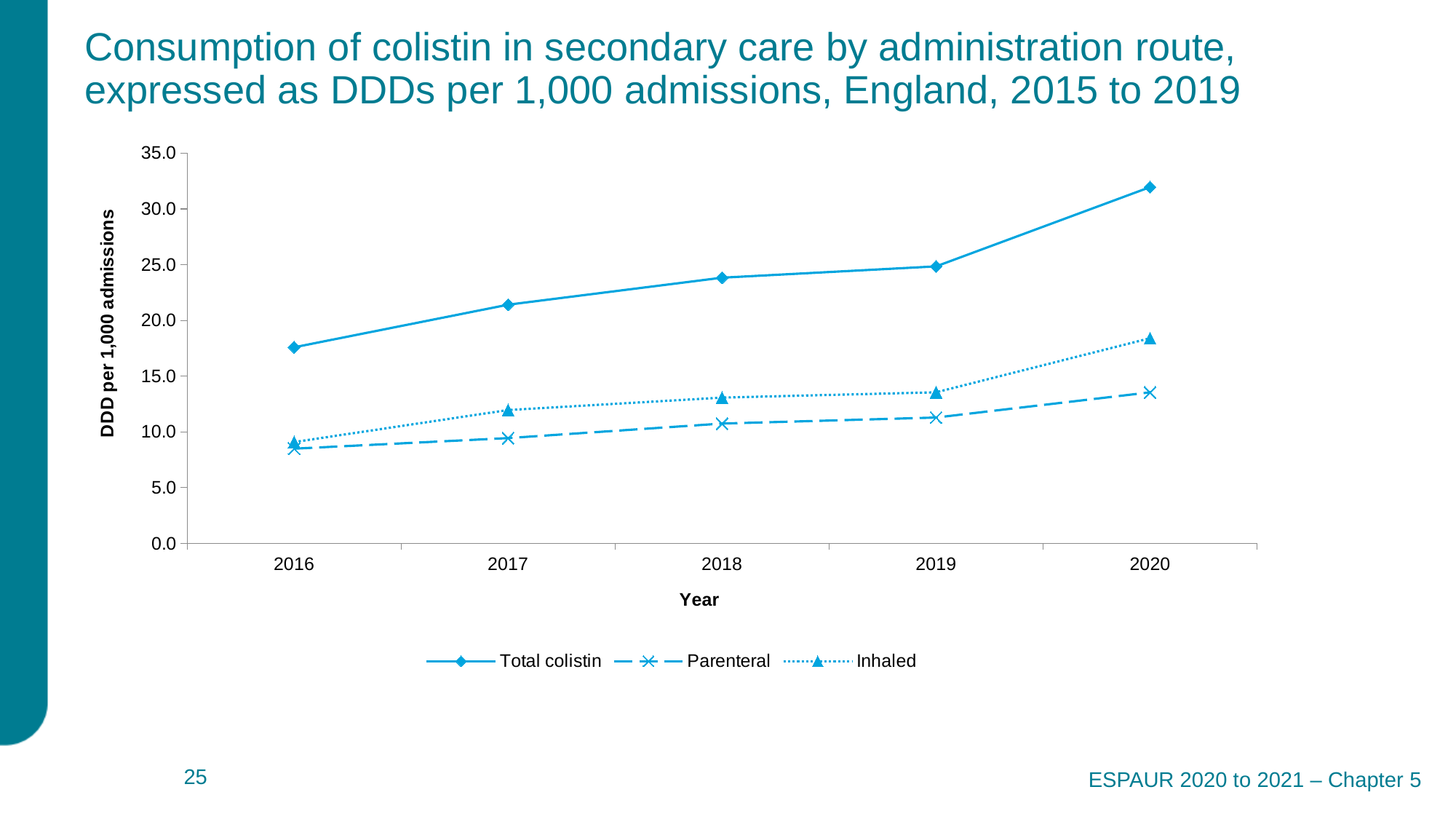
Does the Total colistin series rise or fall from 2016 to 2020? rise Is the Total colistin value for 2020 greater or less than 30.0? greater How many years are plotted along the x axis? 5 In 2020, which is larger, the Inhaled value or the Parenteral value? Inhaled What kind of chart is shown on the slide? line chart What is the label on the y axis? DDD per 1,000 admissions In which year is the Total colistin value highest? 2020 Is the Parenteral value for 2016 greater or less than 10.0? less Is the Inhaled value for 2020 greater or less than 15.0? greater In which year is the Parenteral value lowest? 2016 How many series does the legend list? 3